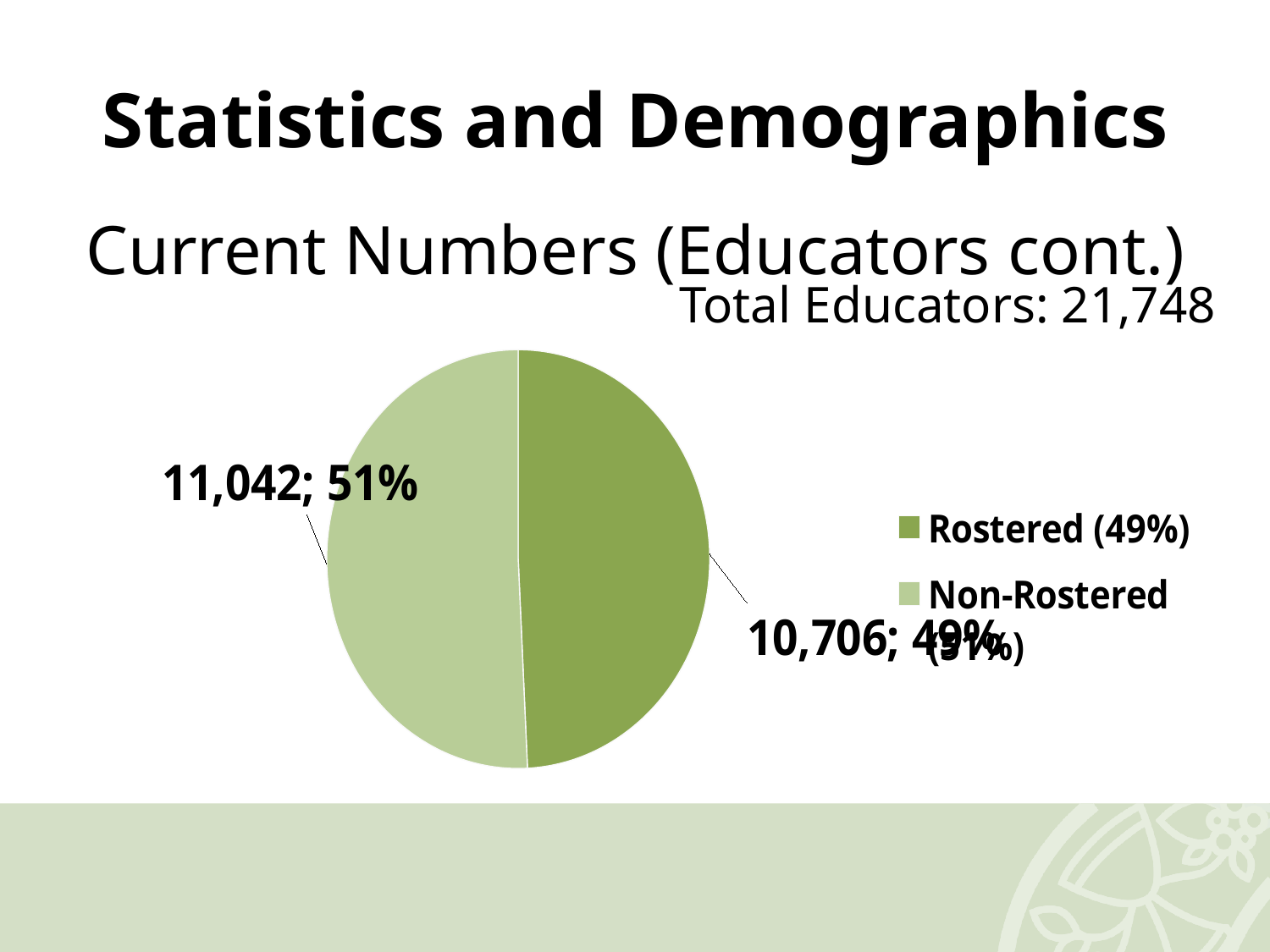
How many entries does the legend of the pie chart list? 2 Which legend entry is shown in the darker green colour? Rostered (49%) What is the total number of educators stated on the slide? 21,748 What kind of chart is shown on the slide? pie chart Which slice of the pie chart is the smallest? Rostered What share of the pie does the Non-Rostered slice represent? 51% What is the value shown for the Rostered slice? 10,706 How many slices does the pie chart have? 2 What is the difference between the Non-Rostered value and the Rostered value? 336 Which slice of the pie chart is the largest? Non-Rostered What is the value shown for the Non-Rostered slice? 11,042 What share of the pie does the Rostered slice represent? 49%